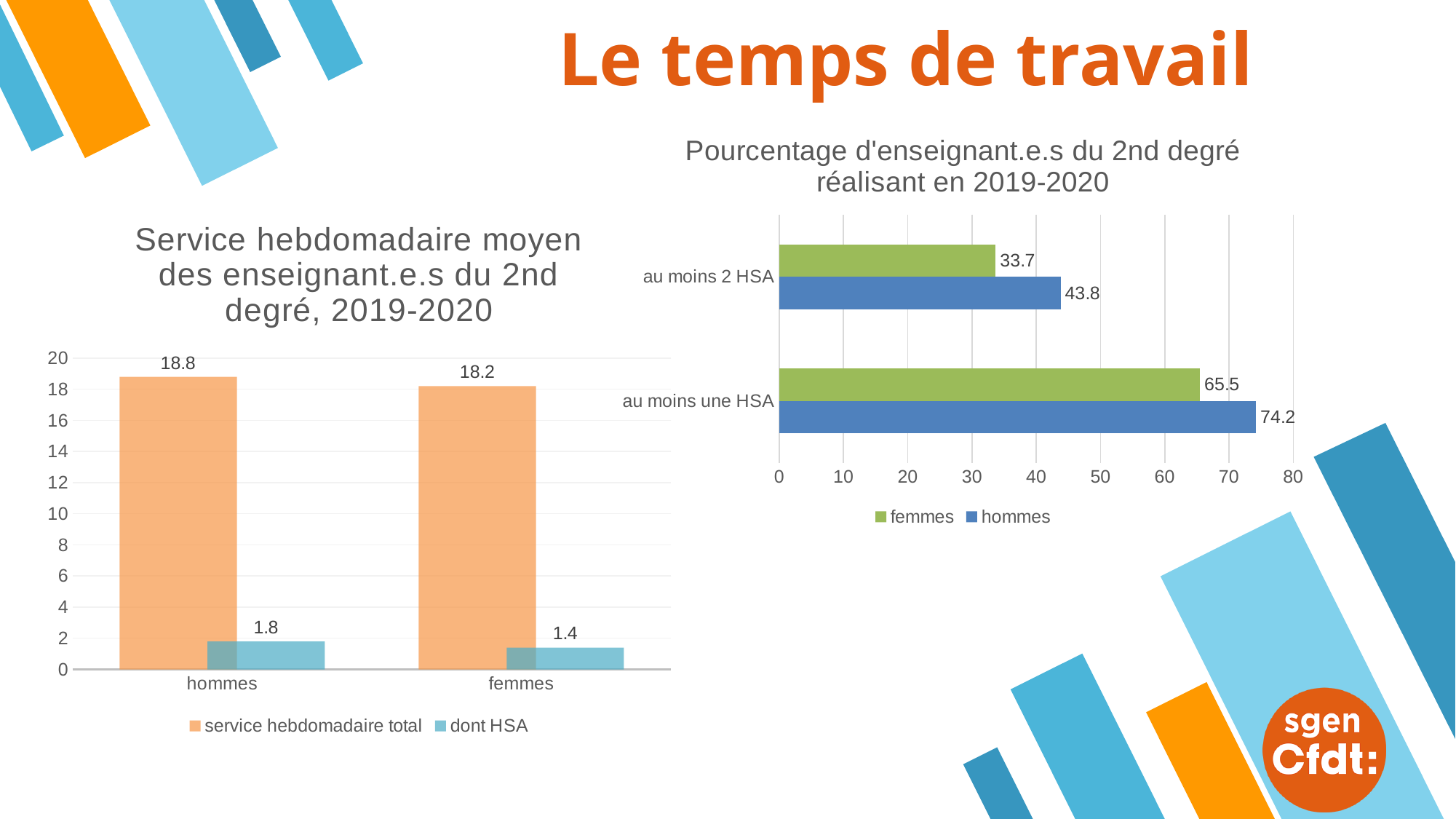
In the left chart (Service hebdomadaire moyen), which category has the higher 'dont HSA' value, hommes or femmes? hommes In the right chart (Pourcentage d'enseignant.e.s du 2nd degré), what colour represents the femmes series? green In the right chart (Pourcentage d'enseignant.e.s du 2nd degré), which series has the highest value overall? hommes In the right chart (Pourcentage d'enseignant.e.s du 2nd degré), what is the value for hommes for 'au moins une HSA'? 74.2 In the left chart (Service hebdomadaire moyen), how many series does the legend list? 2 In the right chart (Pourcentage d'enseignant.e.s du 2nd degré), what is the value for femmes for 'au moins 2 HSA'? 33.7 In the left chart (Service hebdomadaire moyen), what type of chart is shown? bar chart In the left chart (Service hebdomadaire moyen), what is the value of 'dont HSA' for femmes? 1.4 In the right chart (Pourcentage d'enseignant.e.s du 2nd degré), what is the difference between hommes and femmes for 'au moins une HSA'? 8.7 In the left chart (Service hebdomadaire moyen), what is the value of 'service hebdomadaire total' for hommes? 18.8 In the left chart (Service hebdomadaire moyen), what is the difference between the 'service hebdomadaire total' values for hommes and femmes? 0.6 In the right chart (Pourcentage d'enseignant.e.s du 2nd degré), how many categories are shown on the vertical axis? 2